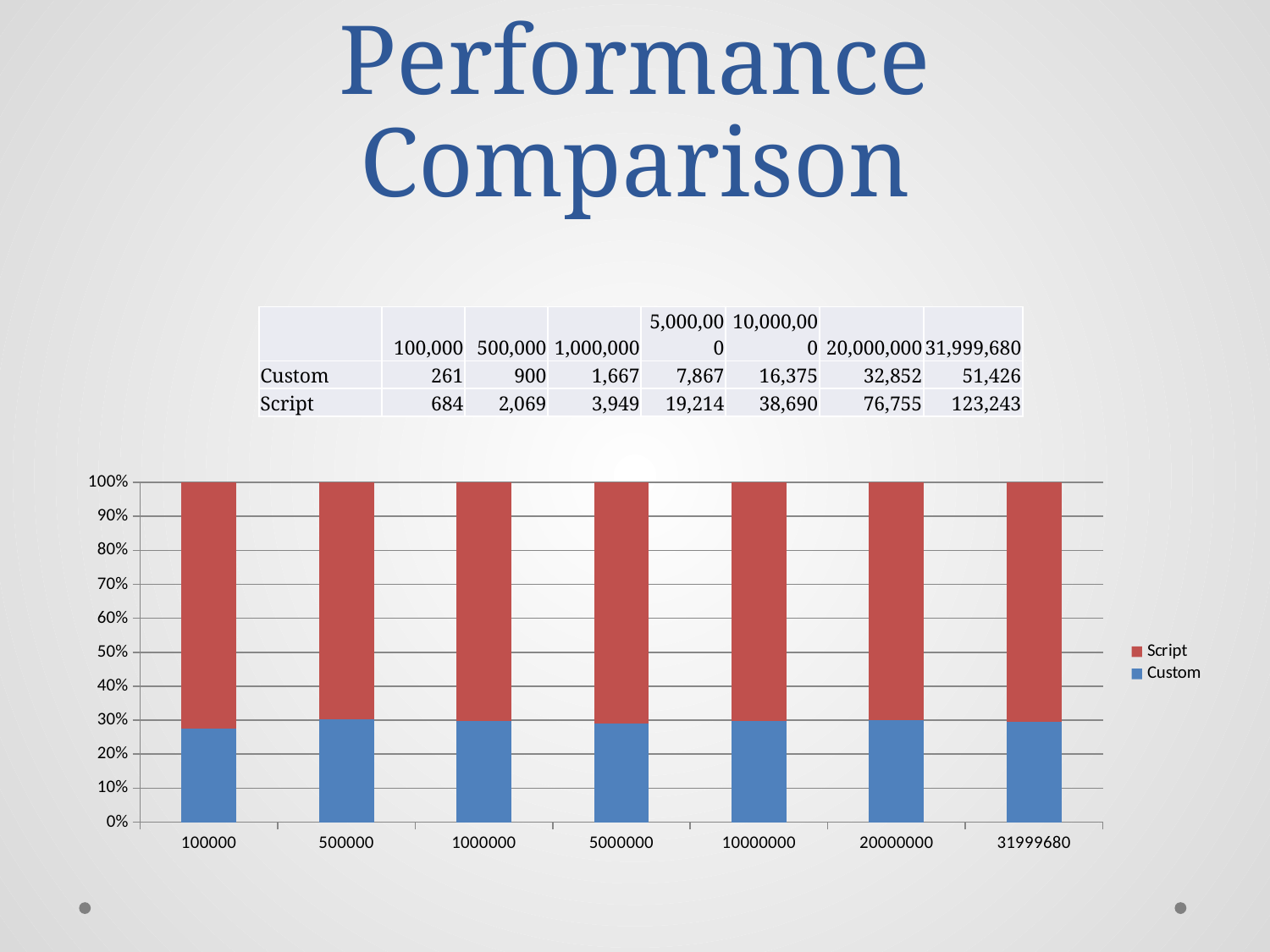
Do the Script values in the table rise or fall as the category size increases? Rise Which category has the lowest Script value in the table? 100,000 Which series is shown in red in the chart? Script Which category has the highest Custom value in the table? 31,999,680 Is the Custom share of the bar for 100000 greater or less than 30%? less According to the table, what is the Script value for 31,999,680? 123,243 How many categories are shown along the x axis of the chart? 7 What is the difference between the Script and Custom values for 100,000? 423 According to the table, what is the Custom value for 100,000? 261 How many series does the chart legend list? 2 What kind of chart is shown on the slide? Stacked bar chart According to the table, what is the Script value for 5,000,000? 19,214